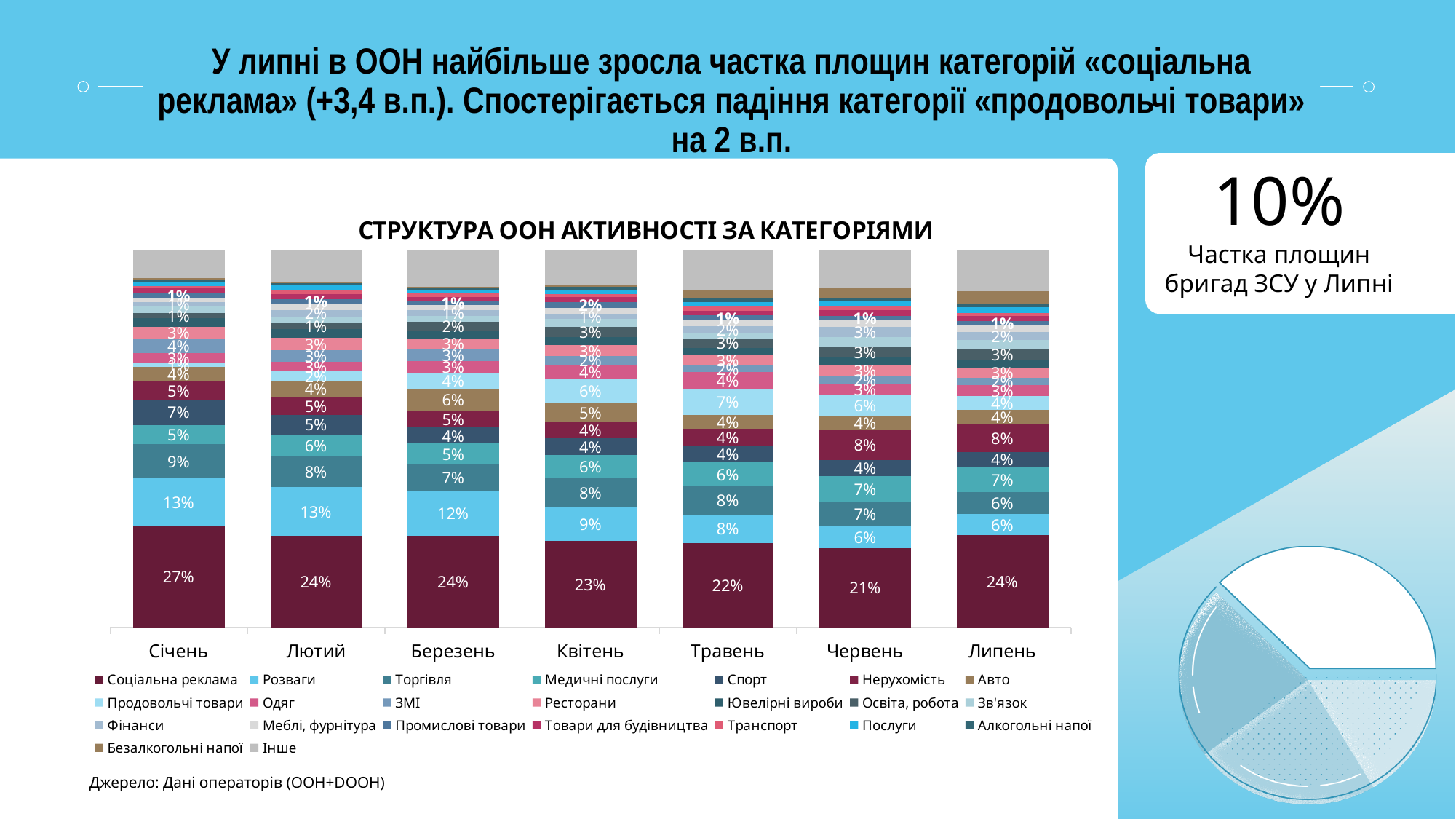
How many series does the chart legend list? 23 What is the value of Соціальна реклама for Січень? 27% Does the Розваги share rise or fall from Січень to Липень? Fall What is the value of Розваги for Липень? 6% Which month has a larger Розваги share, Січень or Липень? Січень What is the difference between the Соціальна реклама share in Січень and in Червень? 6 percentage points In which month is the Соціальна реклама share the highest? Січень How many months are shown on the x axis of the chart? 7 In which month is the Соціальна реклама share the lowest? Червень What is the value of Нерухомість for Липень? 8% What is the value of Торгівля for Січень? 9% What type of chart is shown on the slide? Stacked bar chart